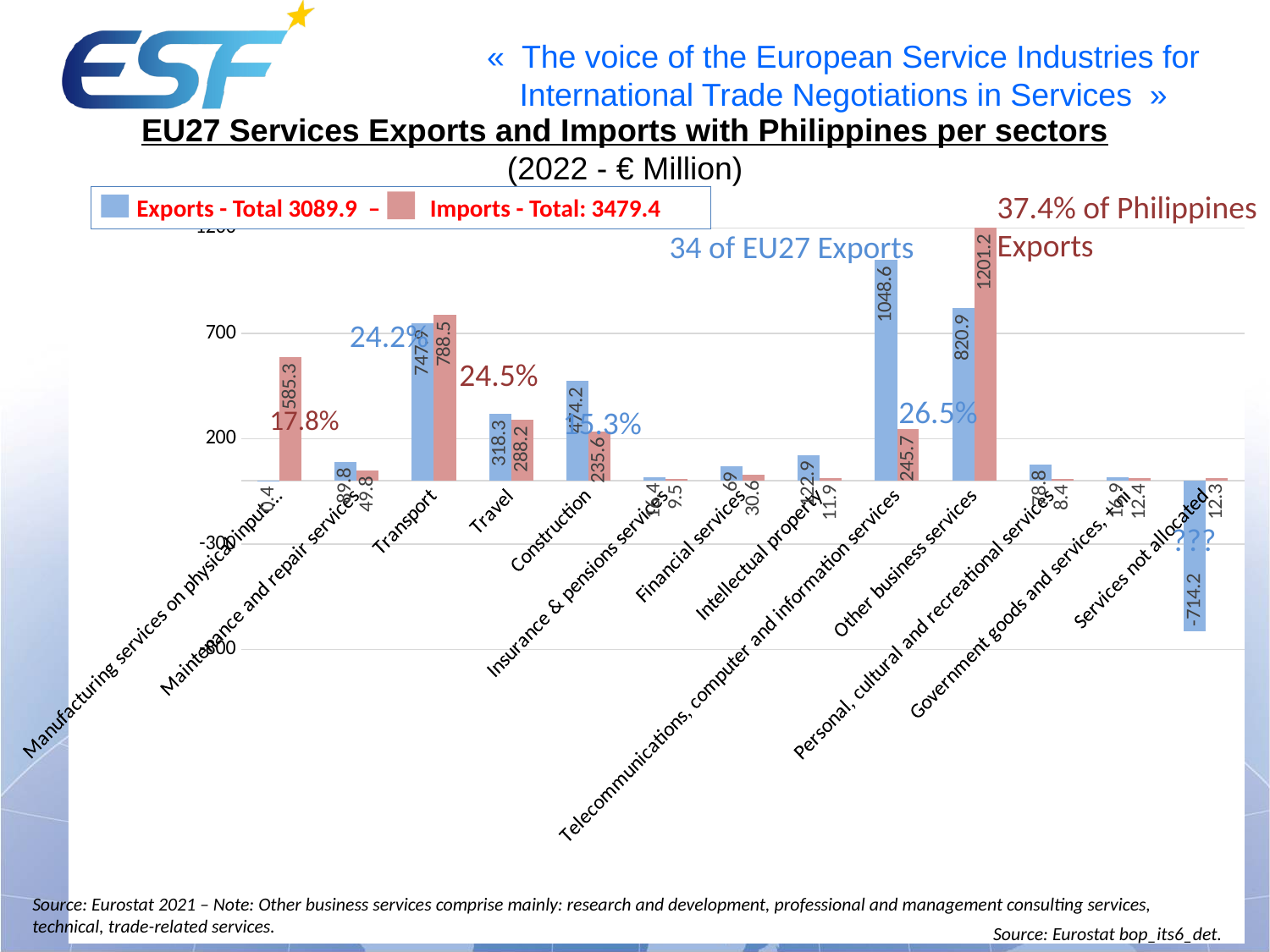
How many sector categories are plotted on the x axis? 13 For Manufacturing services on physical inputs, which is larger, Exports or Imports? Imports What is the difference between Exports and Imports for Construction? 238.6 What is the Exports value for Services not allocated? -714.2 How many series does the legend list? 2 According to the legend, what is the total of Exports? 3089.9 Which sector has the highest Imports value? Other business services What is the Exports value for Telecommunications, computer and information services? 1048.6 What kind of chart is shown on the slide? Bar chart Which sector has the highest Exports value? Telecommunications, computer and information services Is the Imports value for Transport greater or less than 700? greater What is the Imports value for Other business services? 1201.2